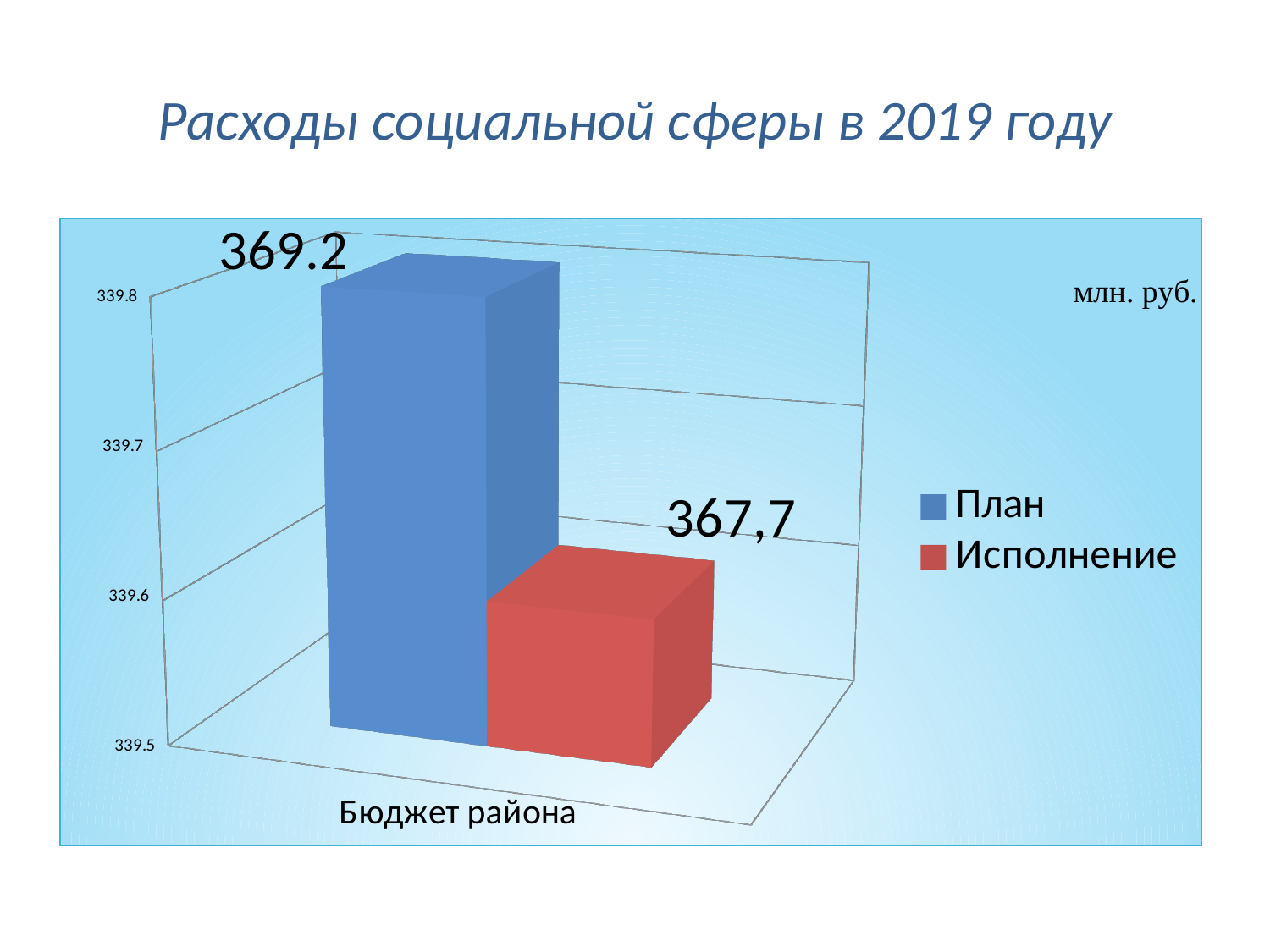
Which series has the lowest value on the chart? Исполнение What unit is indicated on the chart? млн. руб. How many series does the legend list? 2 What is the difference between the План value and the Исполнение value? 1.5 What kind of chart is shown on the slide? Bar chart What is the name of the category on the x axis? Бюджет района What is the title of the slide? Расходы социальной сферы в 2019 году Which series has the highest value on the chart? План What is the value of the План bar? 369.2 Which series has the higher value, План or Исполнение? План What is the value of the Исполнение bar? 367,7 How many categories are shown on the x axis? 1